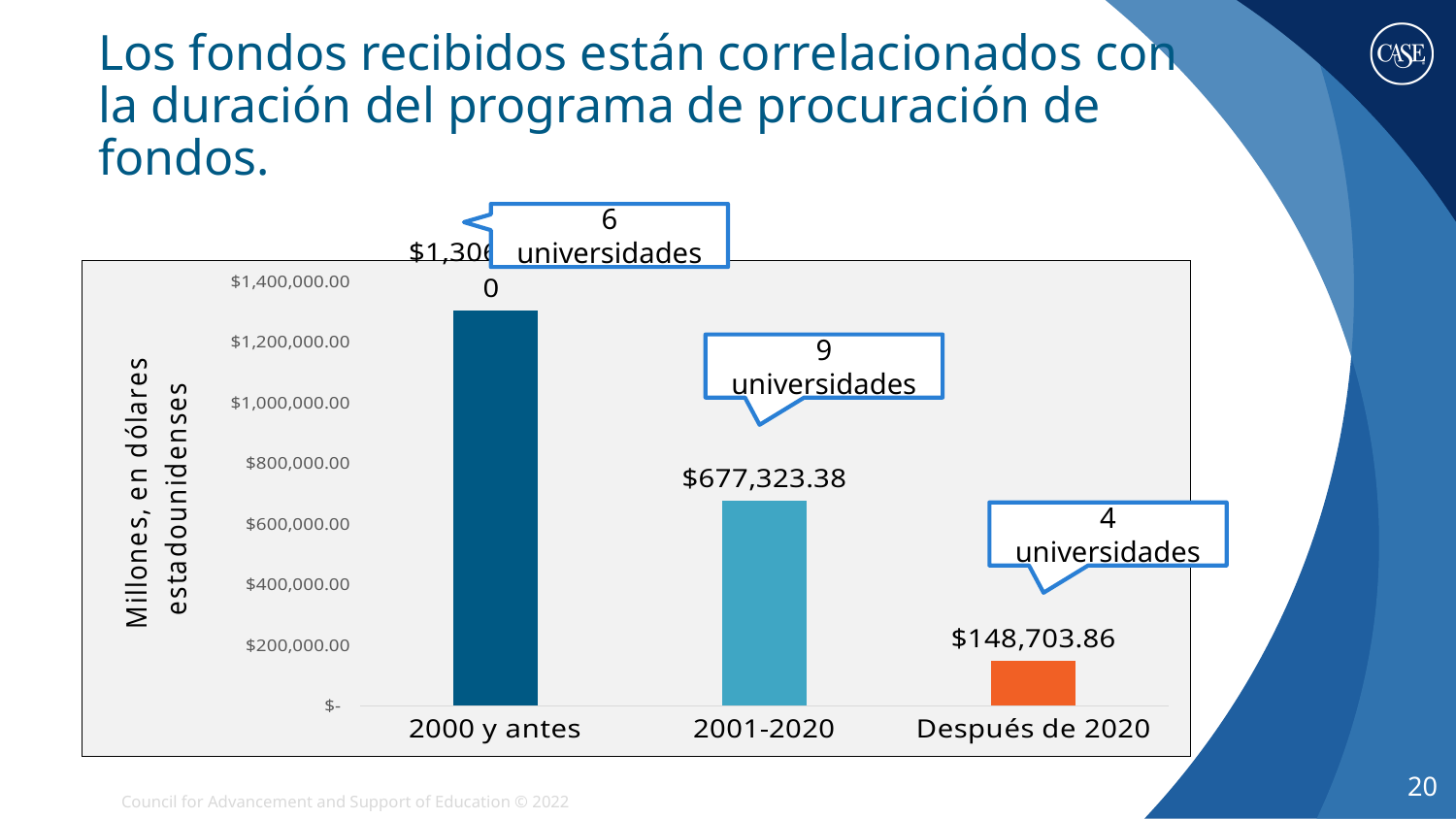
Do the values rise or fall from left to right along the x axis? fall Is the value for 2001-2020 greater or less than $800,000.00? less What is the difference between the values for 2001-2020 and Después de 2020? $528,619.52 Which category has the highest value? 2000 y antes Which is larger, the value for 2001-2020 or the value for Después de 2020? 2001-2020 What kind of chart is shown on the slide? bar chart Which category has the lowest value? Después de 2020 Is the value for 2000 y antes greater or less than $1,200,000.00? greater What is the value for the 2001-2020 category? $677,323.38 What is the value for the Después de 2020 category? $148,703.86 According to the callout, how many universities are in the 2001-2020 category? 9 universidades How many categories are shown on the x axis? 3